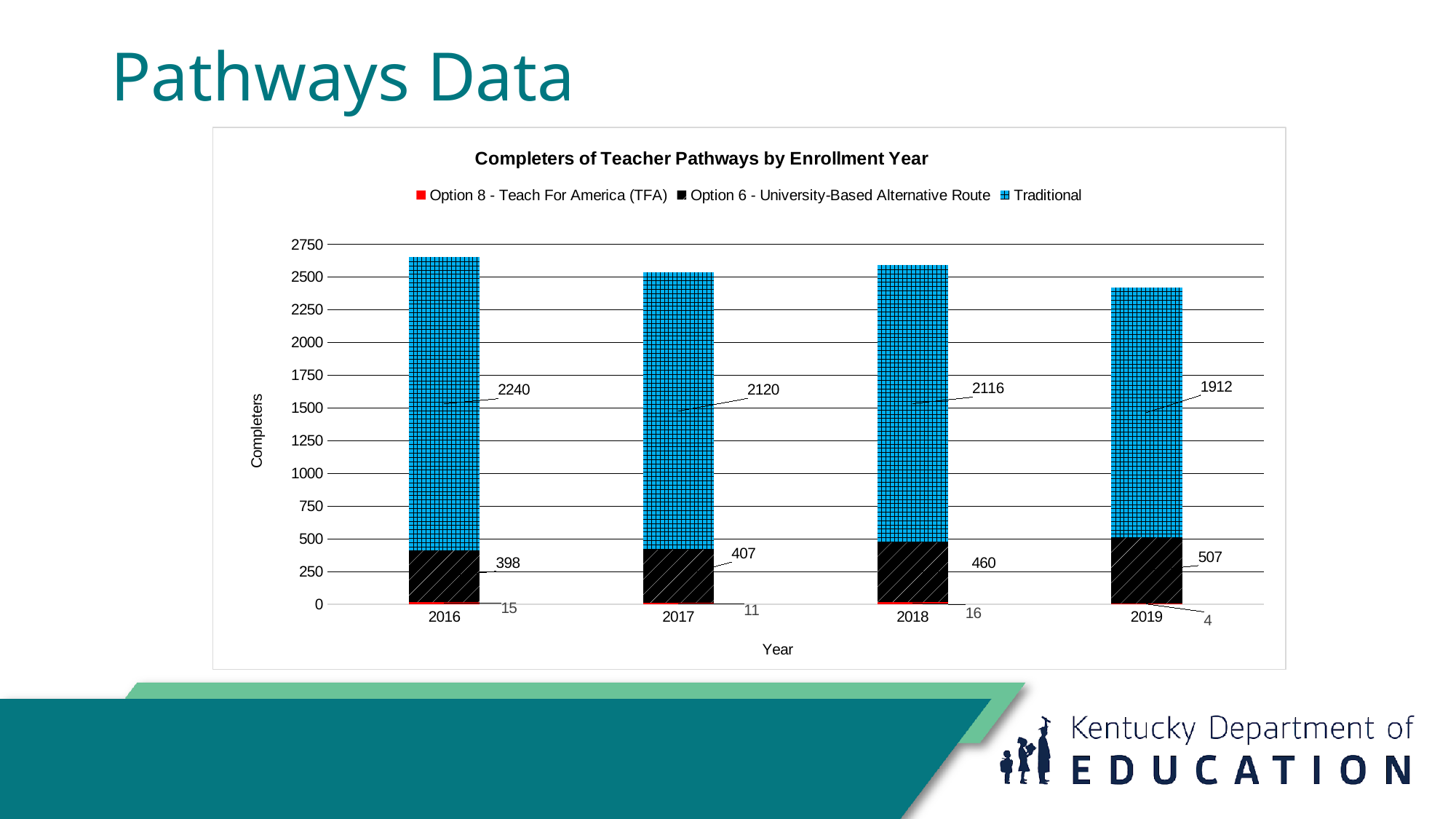
What is the title of the chart? Completers of Teacher Pathways by Enrollment Year What is the Option 6 - University-Based Alternative Route value for 2019? 507 Which is larger, the Option 6 - University-Based Alternative Route value for 2018 or for 2017? 2018 Which year has the lowest Option 8 - Teach For America (TFA) value? 2019 What is the Traditional value for 2016? 2240 How many years are shown on the x axis? 4 Which year has the highest Traditional value? 2016 How many series does the legend list? 3 What is the difference between the Traditional values for 2016 and 2019? 328 What is the Option 8 - Teach For America (TFA) value for 2017? 11 What is the total of the stacked bar for 2019? 2423 What kind of chart is shown? Stacked bar chart